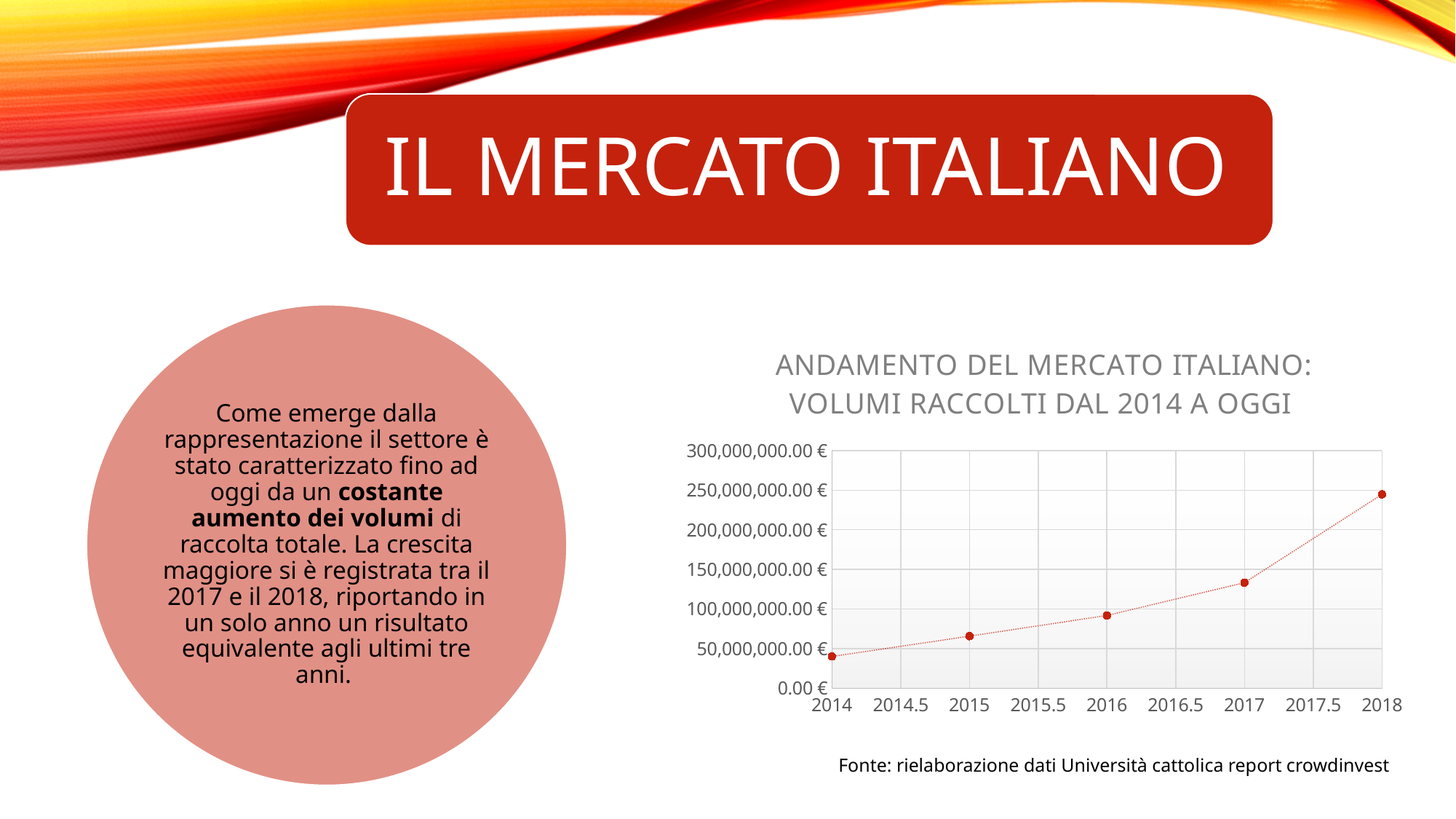
Is the value for 2018 greater or less than 200,000,000.00 €? greater Is the value for 2017 greater or less than 100,000,000.00 €? greater Is the value for 2014 greater or less than 50,000,000.00 €? less What is the highest value shown on the vertical axis of the chart? 300,000,000.00 € Do the values rise or fall from 2014 to 2018? rise Which year has the highest value on the chart? 2018 Which is larger, the value for 2017 or the value for 2018? 2018 Which year has the lowest value on the chart? 2014 What is the title of the chart? ANDAMENTO DEL MERCATO ITALIANO: VOLUMI RACCOLTI DAL 2014 A OGGI What kind of chart is shown on the slide? line chart How many data points are plotted on the chart? 5